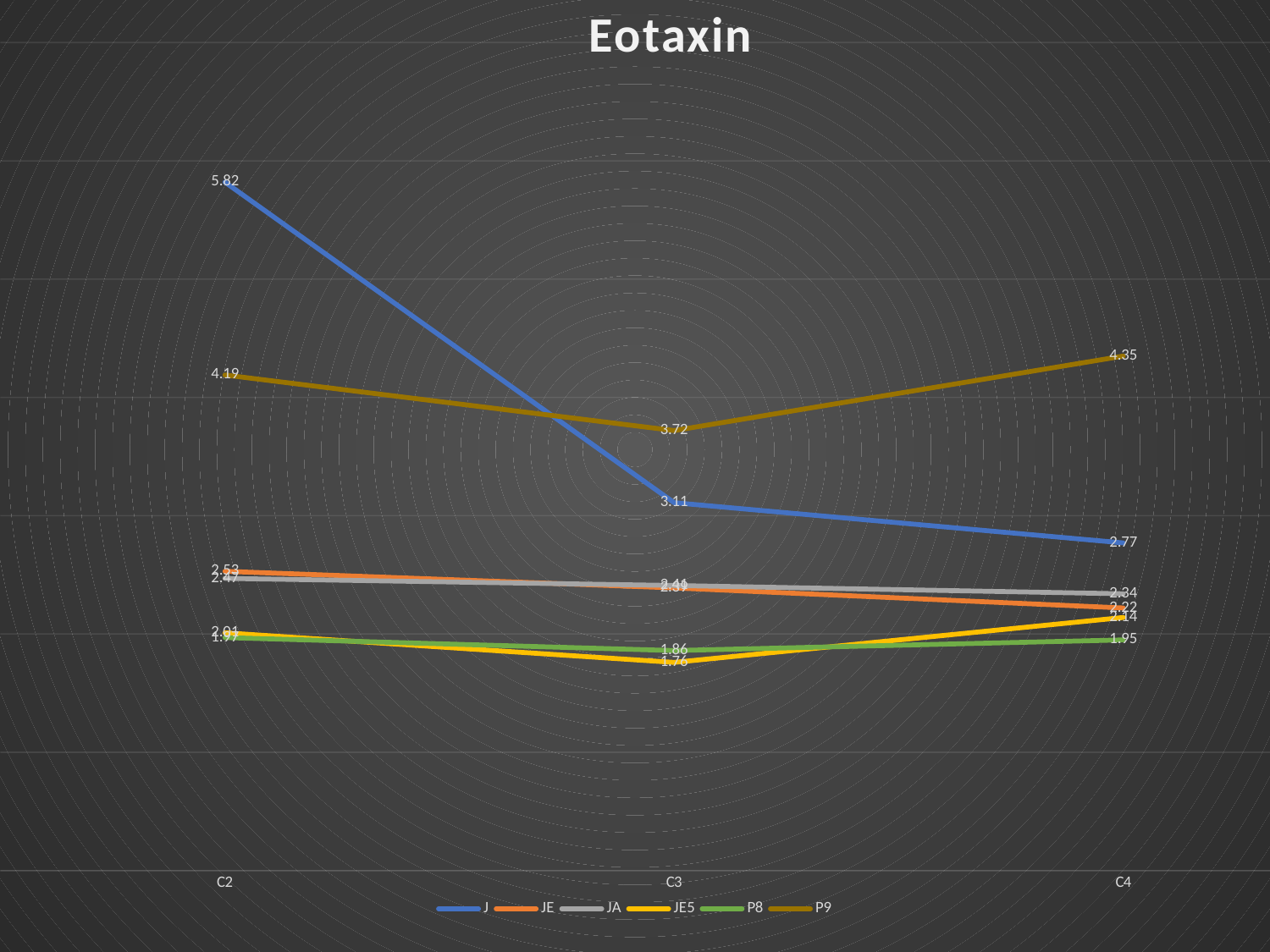
What is the value of series JE5 at C4? 2.14 Which is larger: the value of series J at C4 or the value of series P9 at C4? P9 at C4 What is the value of series P9 at C3? 3.72 What is the difference between the value of series J at C2 and at C3? 2.71 Which series has the highest value at C4? P9 How many series does the legend list? 6 Does the value of series J rise or fall from C2 to C4? fall Which series has the lowest value at C3? JE5 What is the value of series J at C2? 5.82 What kind of chart is shown on the slide? line chart What is the title of the chart? Eotaxin How many categories are shown on the x axis? 3